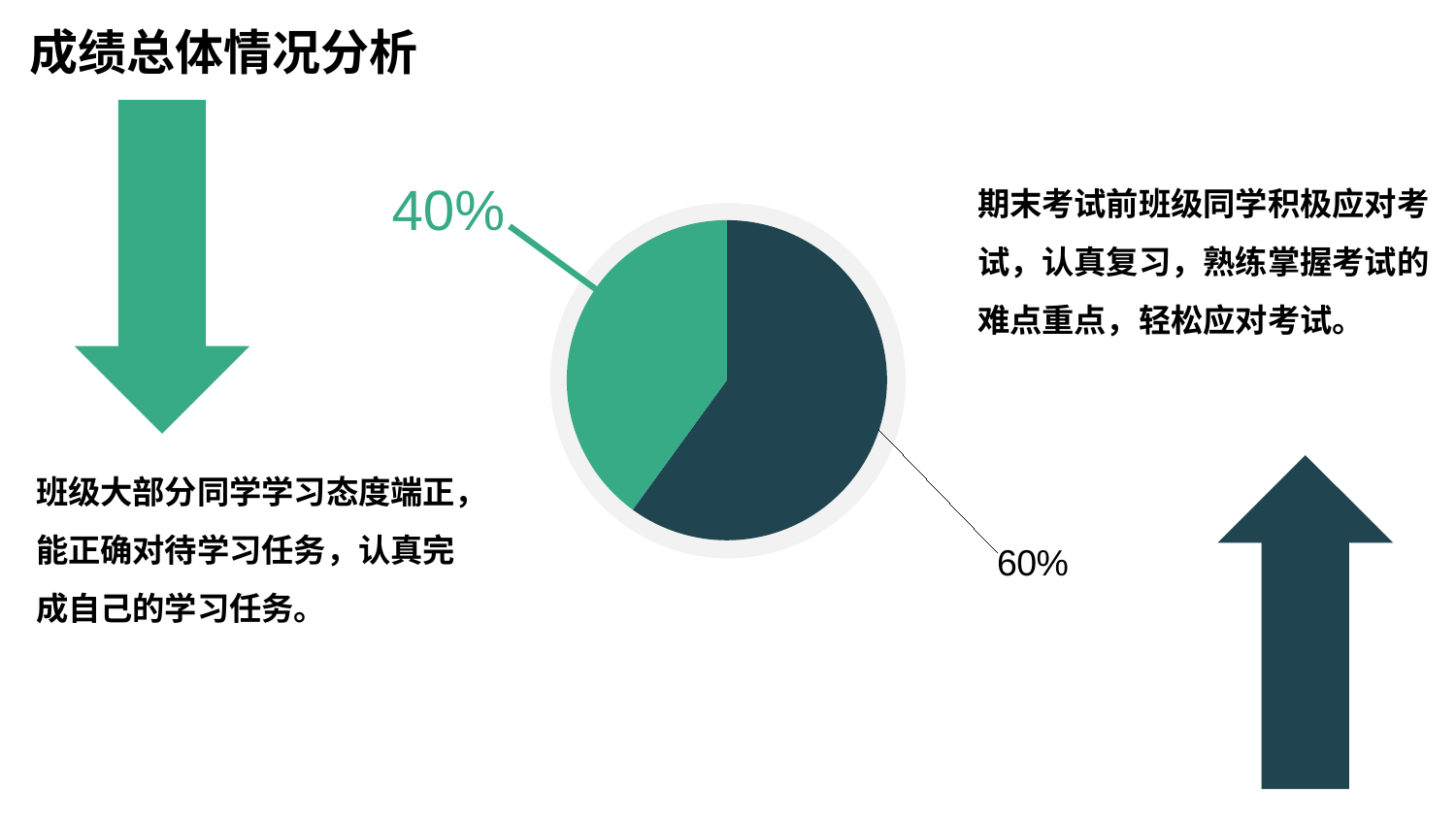
What is the title of the slide containing the pie chart? 成绩总体情况分析 What is the difference in percentage points between the dark teal slice and the green slice? 20 What percentage is shown for the green slice of the pie chart? 40% What share of the pie does the green slice represent? 40% What kind of chart is shown on the slide? pie chart What percentage is shown for the dark teal slice of the pie chart? 60% What colour is the slice labelled 60%? dark teal Which is larger, the green slice or the dark teal slice? the dark teal slice Which slice of the pie chart is the smallest? the green slice (40%) Which slice of the pie chart is the largest? the dark teal slice (60%) How many slices does the pie chart have? 2 What is the total of the two percentages shown on the pie chart? 100%